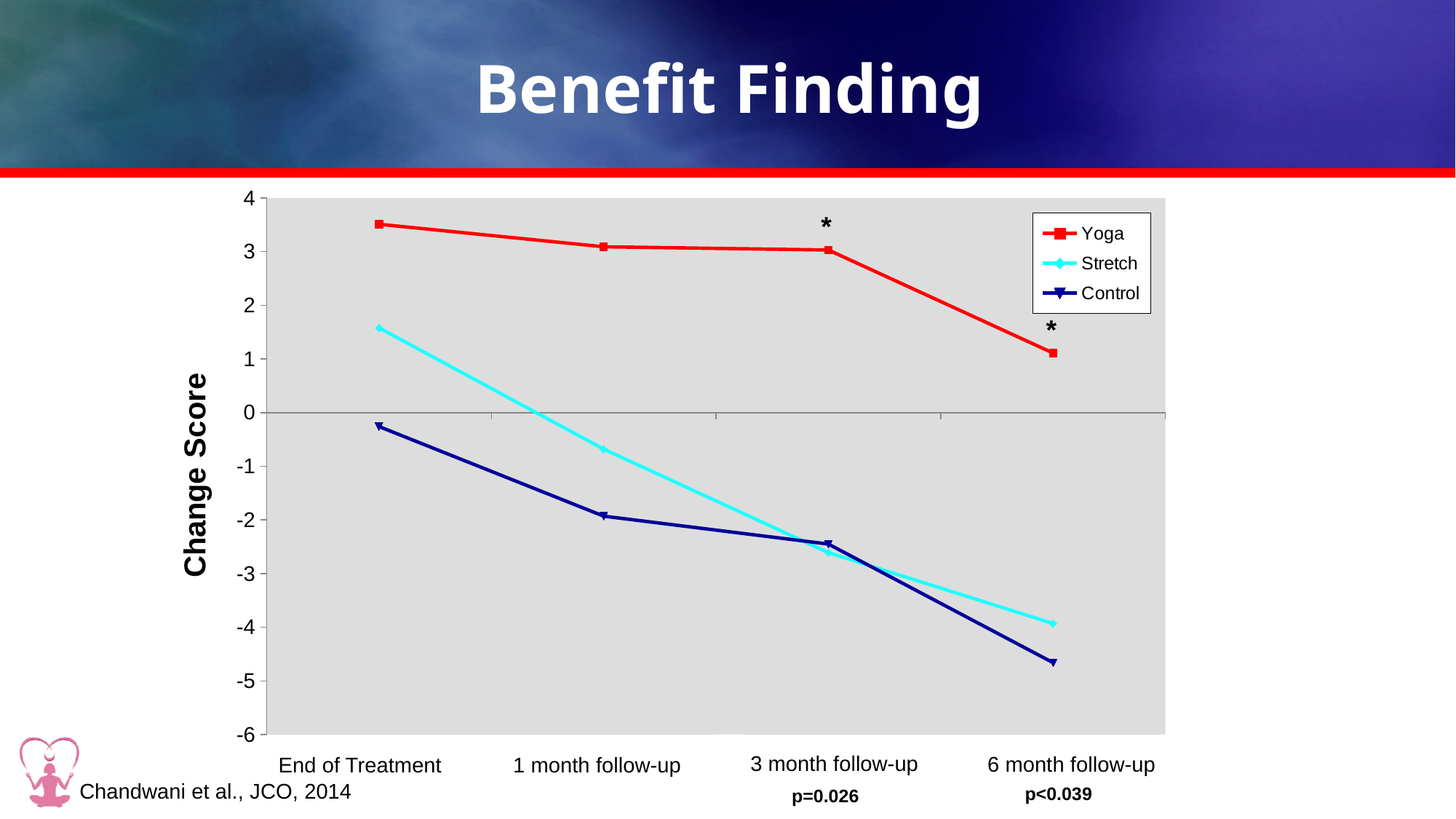
How many series does the legend list? 3 Is the value for Control at 1 month follow-up greater or less than -1? less Which series has the highest value at End of Treatment? Yoga Is the value for Yoga at End of Treatment greater or less than 3? greater How many time points are shown along the x axis? 4 Does the Yoga line rise or fall from End of Treatment to 6 month follow-up? fall What kind of chart is shown on the slide? line chart Does the Stretch line rise or fall across the time points? fall Is the value for Stretch at 6 month follow-up greater or less than -3? less At 6 month follow-up, which is larger: the value for Yoga or the value for Control? Yoga Which series has the lowest value at 6 month follow-up? Control